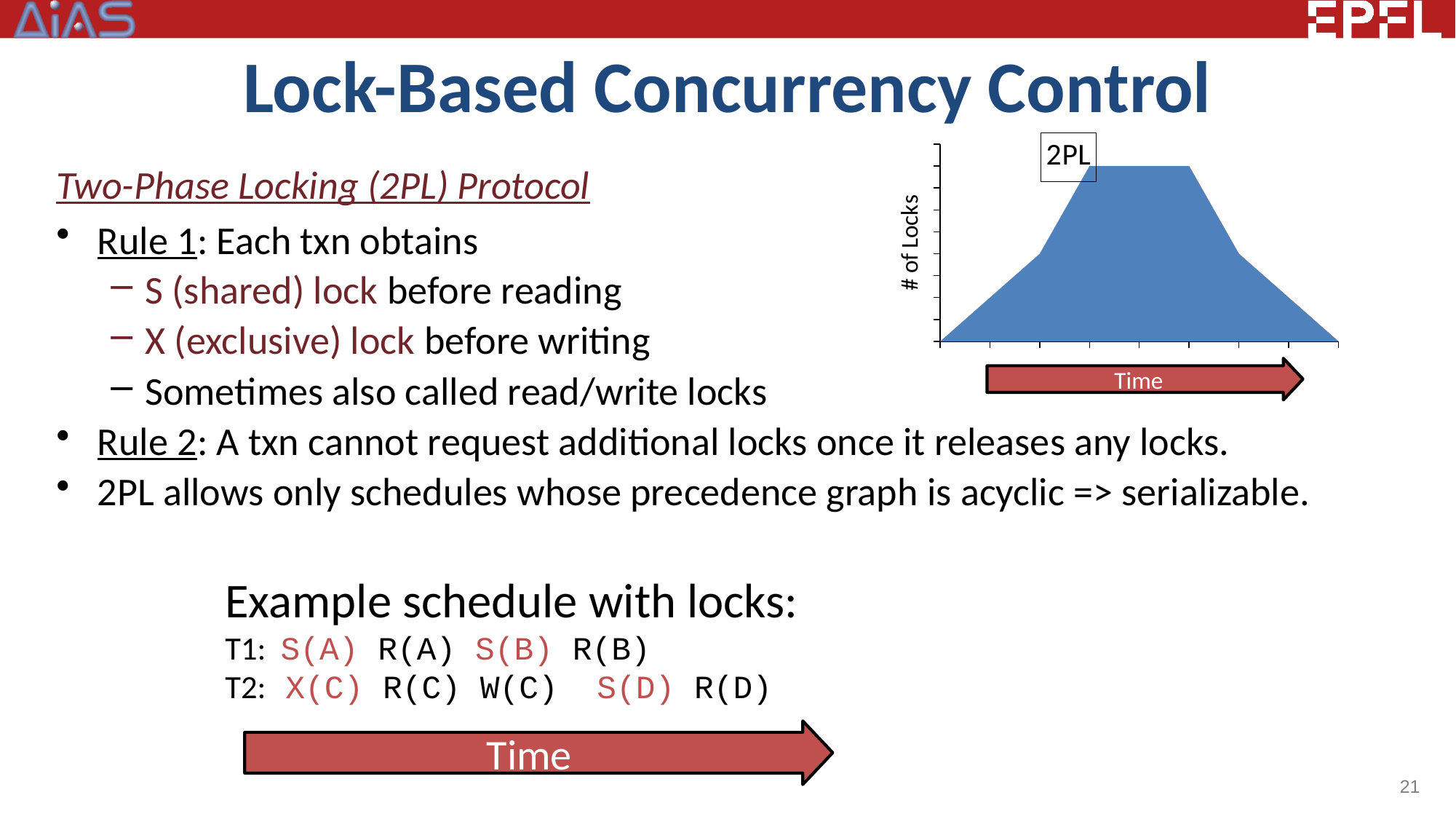
What is the label on the horizontal axis of the chart? Time What is the label on the vertical axis of the chart? # of Locks Describe the overall shape of the number of locks over time in the chart. rises, plateaus, then falls What kind of chart is shown in the top-right of the slide? area chart In the chart, does the number of locks rise or fall at the end of the time axis? fall In the chart, does the number of locks rise or fall at the beginning of the time axis? rise